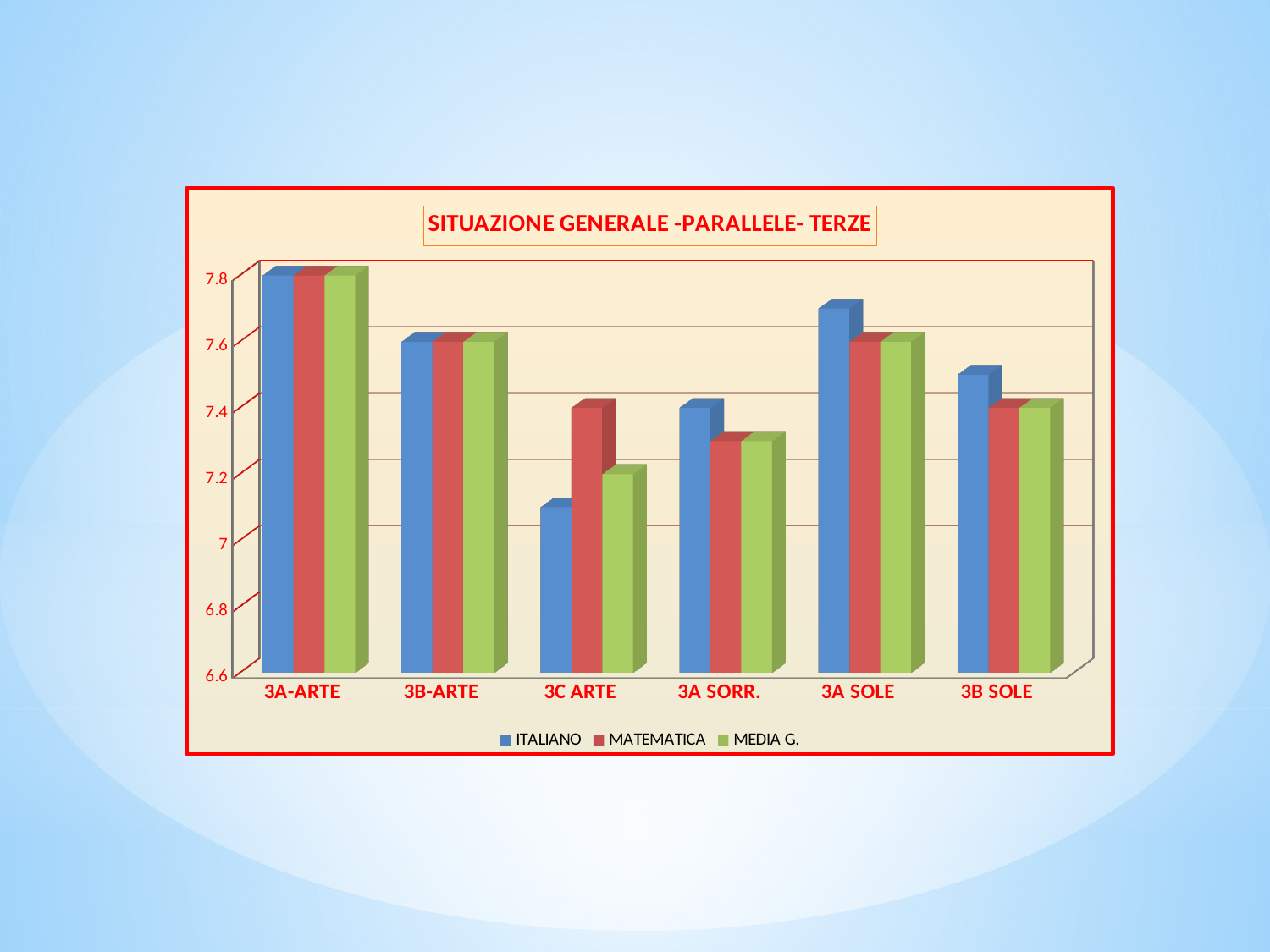
Which colour represents the MEDIA G. series in the legend? green Is the ITALIANO value for 3A SOLE greater or less than 7.6? greater Which class has the highest MEDIA G. value? 3A-ARTE Is the ITALIANO value for 3C ARTE greater or less than 7.2? less What is the title of the chart? SITUAZIONE GENERALE -PARALLELE- TERZE What kind of chart is shown on the slide? bar chart For 3C ARTE, which is larger: the ITALIANO value or the MATEMATICA value? MATEMATICA Which class has the lowest ITALIANO value? 3C ARTE How many classes (categories) are shown on the x axis? 6 What is the MATEMATICA value for 3B-ARTE? 7.6 What is the ITALIANO value for 3A-ARTE? 7.8 How many series does the legend list? 3